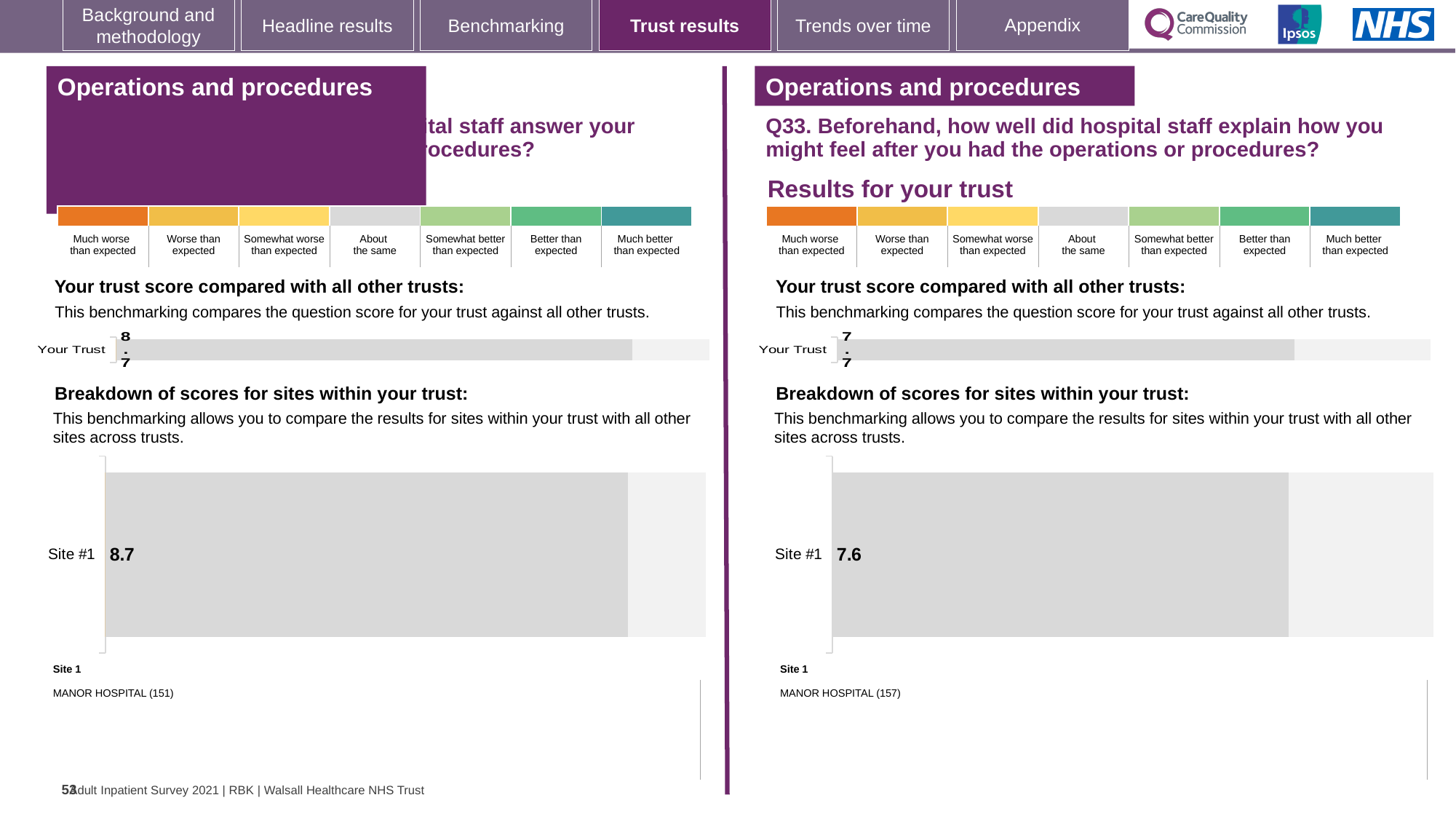
On the left-hand panel, which site is listed as Site 1? MANOR HOSPITAL (151) On the right-hand panel (Q33), what is the score shown for Your Trust? 7.7 On the right-hand panel (Q33), which site is listed as Site 1? MANOR HOSPITAL (157) How many sites are listed in the breakdown of scores for sites within your trust on the right-hand panel (Q33)? 1 Which panel shows the higher Site #1 score, the left-hand panel or the right-hand panel (Q33)? the left-hand panel What type of chart is used to show the Site #1 score on the left-hand panel? bar chart On the left-hand panel, what is the score shown for Your Trust? 8.7 On the right-hand panel (Q33), what is the score shown for Site #1 in the breakdown of scores for sites within your trust? 7.6 On the left-hand panel, what is the score shown for Site #1 in the breakdown of scores for sites within your trust? 8.7 Is the Your Trust score on the left-hand panel greater or less than 8? greater Is the Your Trust score on the right-hand panel (Q33) greater or less than 8? less What is the difference between the Site #1 score on the left-hand panel and the Site #1 score on the right-hand panel (Q33)? 1.1